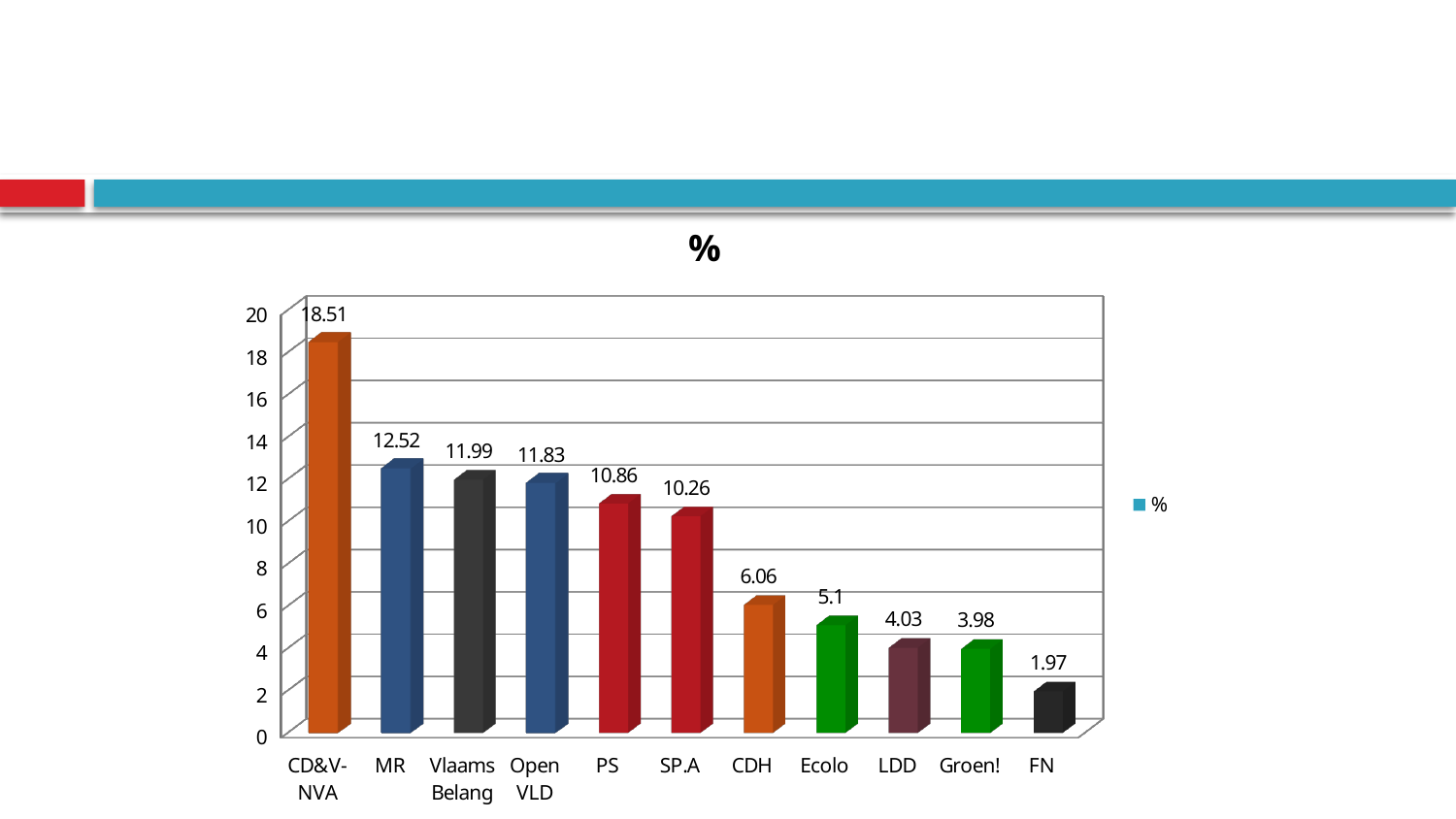
Which is larger, the value for CDH or the value for LDD? CDH What is the value for CD&V-NVA? 18.51 Which category has the highest value? CD&V-NVA What is the value for Ecolo? 5.1 What is the difference between the values for MR and PS? 1.66 What kind of chart is shown? bar chart Which category has the lowest value? FN What is the value for Open VLD? 11.83 What is the title of the chart? % How many series does the legend list? 1 Is the value for SP.A greater or less than 10? greater How many categories are shown on the x axis? 11